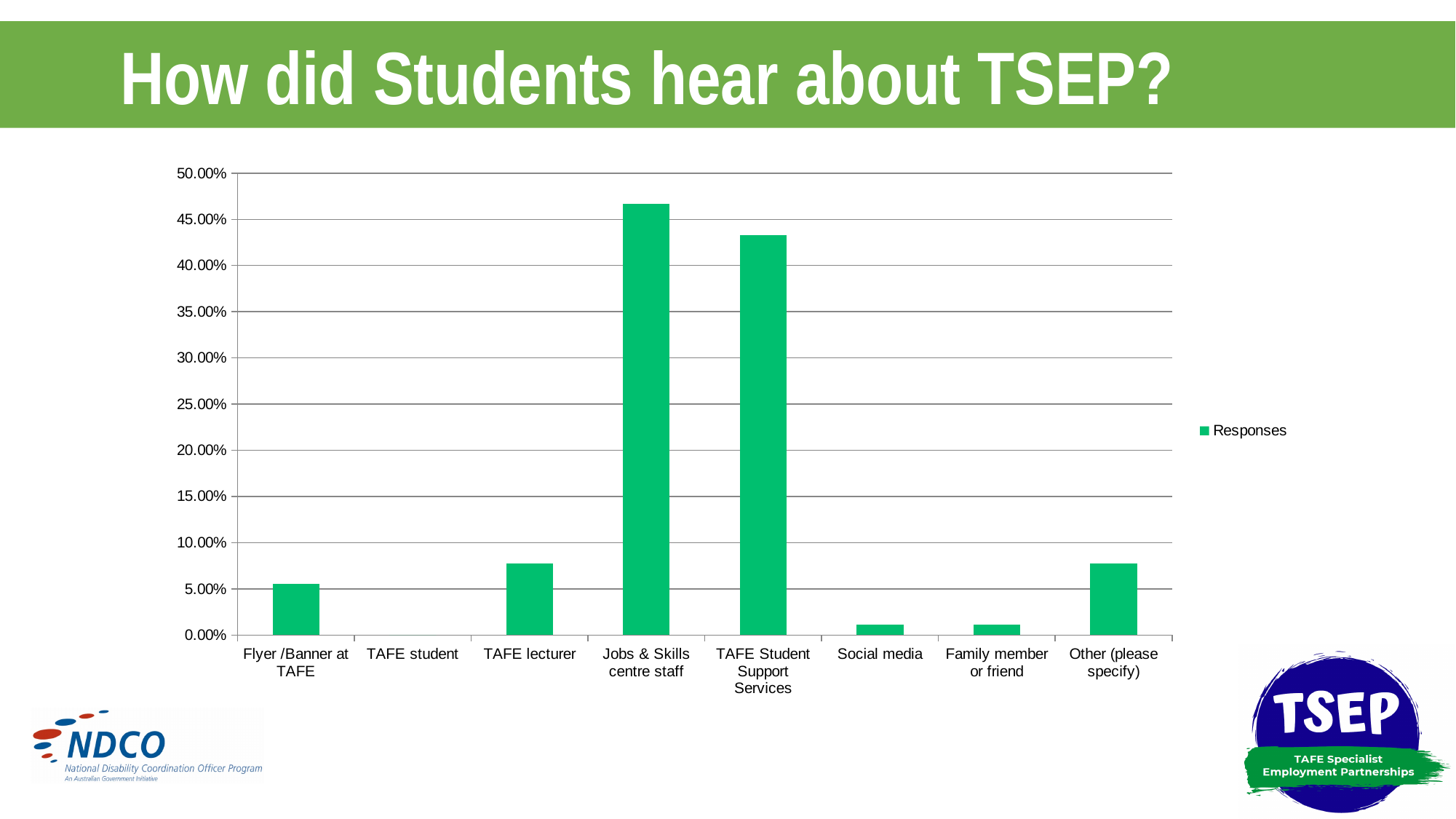
Is the value for Jobs & Skills centre staff greater or less than 45.00%? greater Is the value for Social media greater or less than 5.00%? less How many categories are shown on the x axis of the chart? 8 Which category has the lowest value? TAFE student Is the value for Flyer /Banner at TAFE greater or less than 10.00%? less Which is larger, the value for Jobs & Skills centre staff or the value for TAFE lecturer? Jobs & Skills centre staff What is the title of the slide containing the chart? How did Students hear about TSEP? Which category has the highest value? Jobs & Skills centre staff How many series does the legend list? 1 What type of chart is shown on the slide? bar chart What is the name of the series shown in the legend? Responses